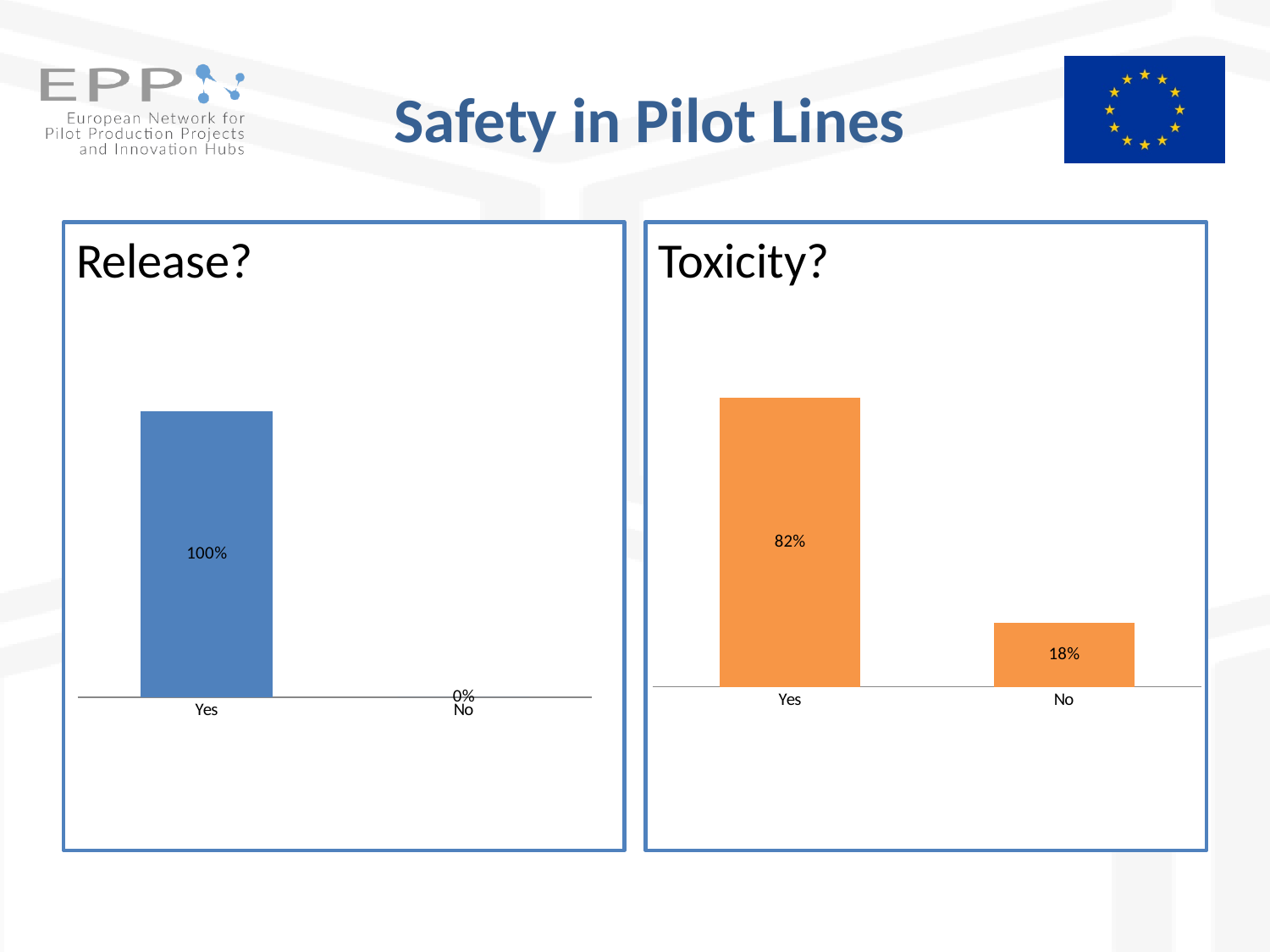
In the "Toxicity?" chart, what is the difference between the values for Yes and No? 64% How many categories does the "Toxicity?" chart show? 2 In the "Release?" chart, what is the difference between the values for Yes and No? 100% In the "Release?" chart, what is the value for No? 0% In the "Release?" chart, which category has the lowest value? No What colour are the bars in the "Toxicity?" chart? Orange In the "Toxicity?" chart, which is larger, the value for Yes or the value for No? Yes In the "Release?" chart, what is the value for Yes? 100% In the "Toxicity?" chart, which category has the highest value? Yes In the "Toxicity?" chart, what is the value for No? 18% What kind of chart is the "Release?" chart? Bar chart In the "Toxicity?" chart, what is the value for Yes? 82%